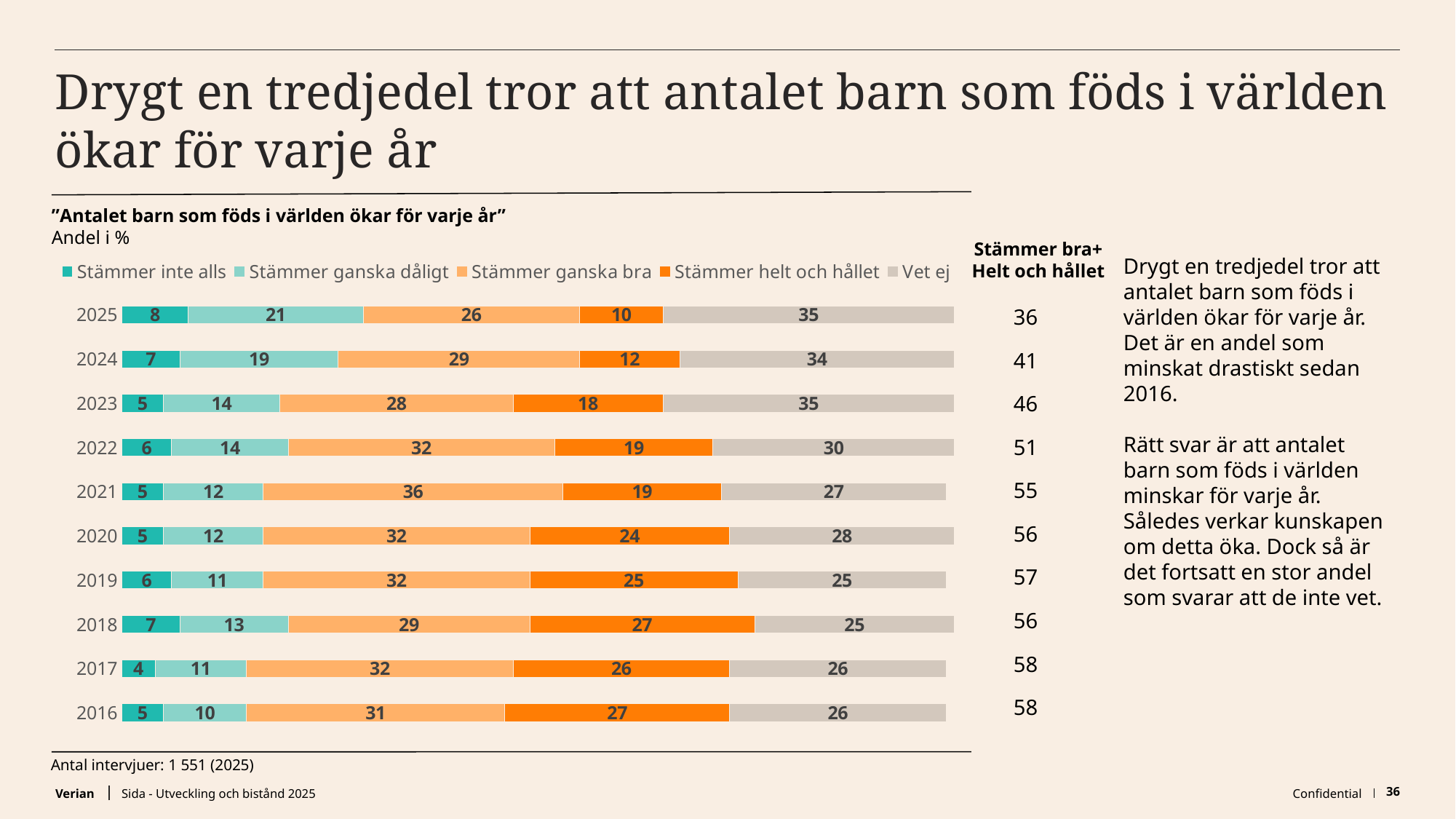
How many years are shown in the chart? 10 What is the total of the stacked bar for 2025? 100 What is the value for "Vet ej" in 2025? 35 Does the value for "Stämmer helt och hållet" rise or fall from 2016 to 2025? Fall How many series does the legend list? 5 Which year has the lowest value for "Stämmer inte alls"? 2017 What kind of chart is shown on the slide? Stacked bar chart Which year has the highest value for "Stämmer inte alls"? 2025 Which year has the larger "Vet ej" value, 2022 or 2021? 2022 What is the value for "Stämmer helt och hållet" in 2018? 27 What is the first entry in the chart legend? Stämmer inte alls What is the difference between the "Stämmer ganska bra" values for 2021 and 2025? 10